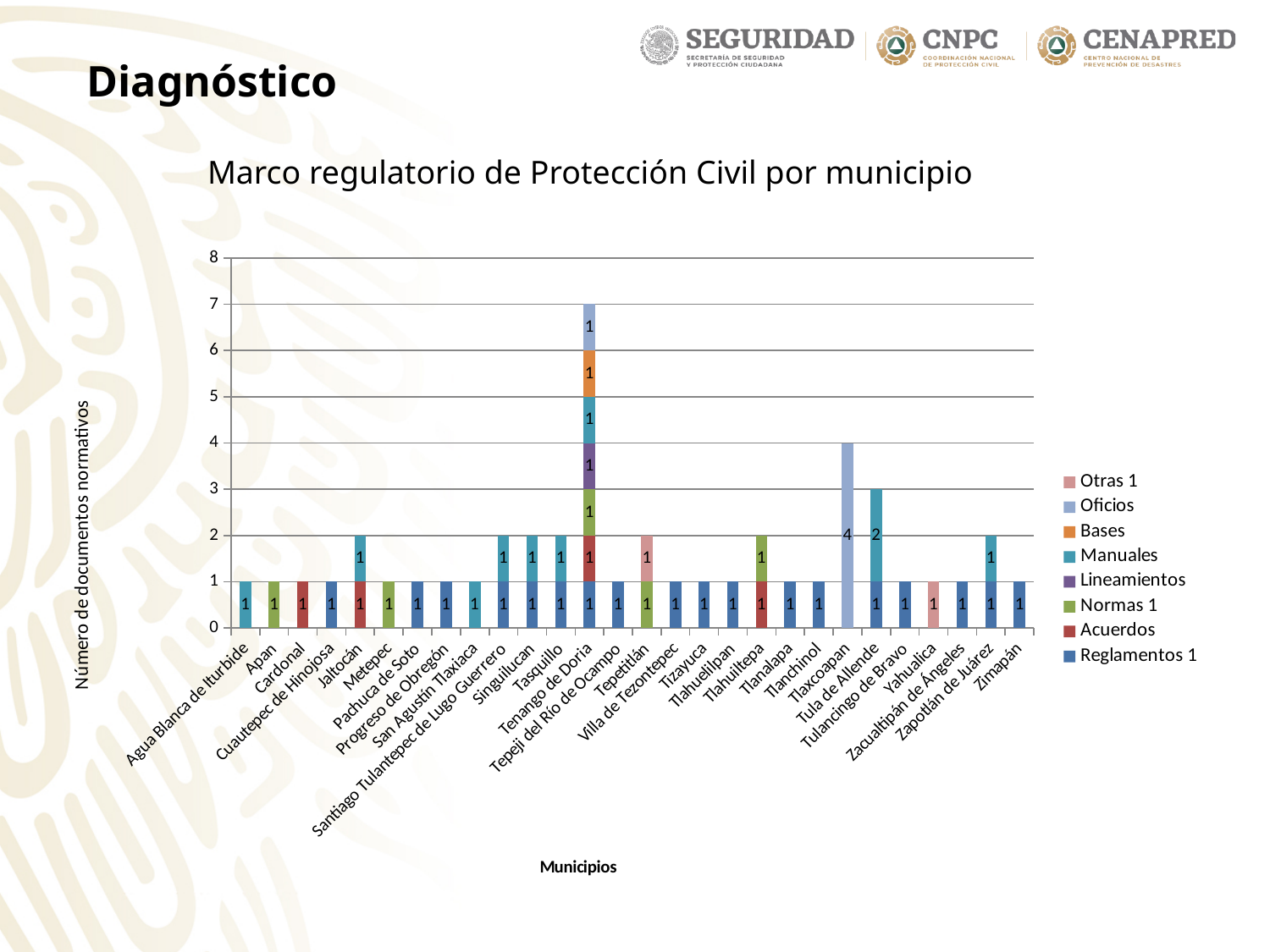
What is the total height of the stacked bar for Tula de Allende? 3 Which is larger, the total for Tlaxcoapan or the total for Tula de Allende? Tlaxcoapan What is the value of the Oficios segment for Tlaxcoapan? 4 What type of chart is shown on the slide? bar chart What is the total height of the stacked bar for Tenango de Doria? 7 What is the value of the Manuales segment for Tula de Allende? 2 Which municipality has the tallest stacked bar? Tenango de Doria How many series does the legend list? 8 What is the difference between the total for Tenango de Doria and the total for Tlaxcoapan? 3 What is the label of the vertical axis? Número de documentos normativos What is the total height of the stacked bar for Jaltocán? 2 What is the title of the chart? Marco regulatorio de Protección Civil por municipio